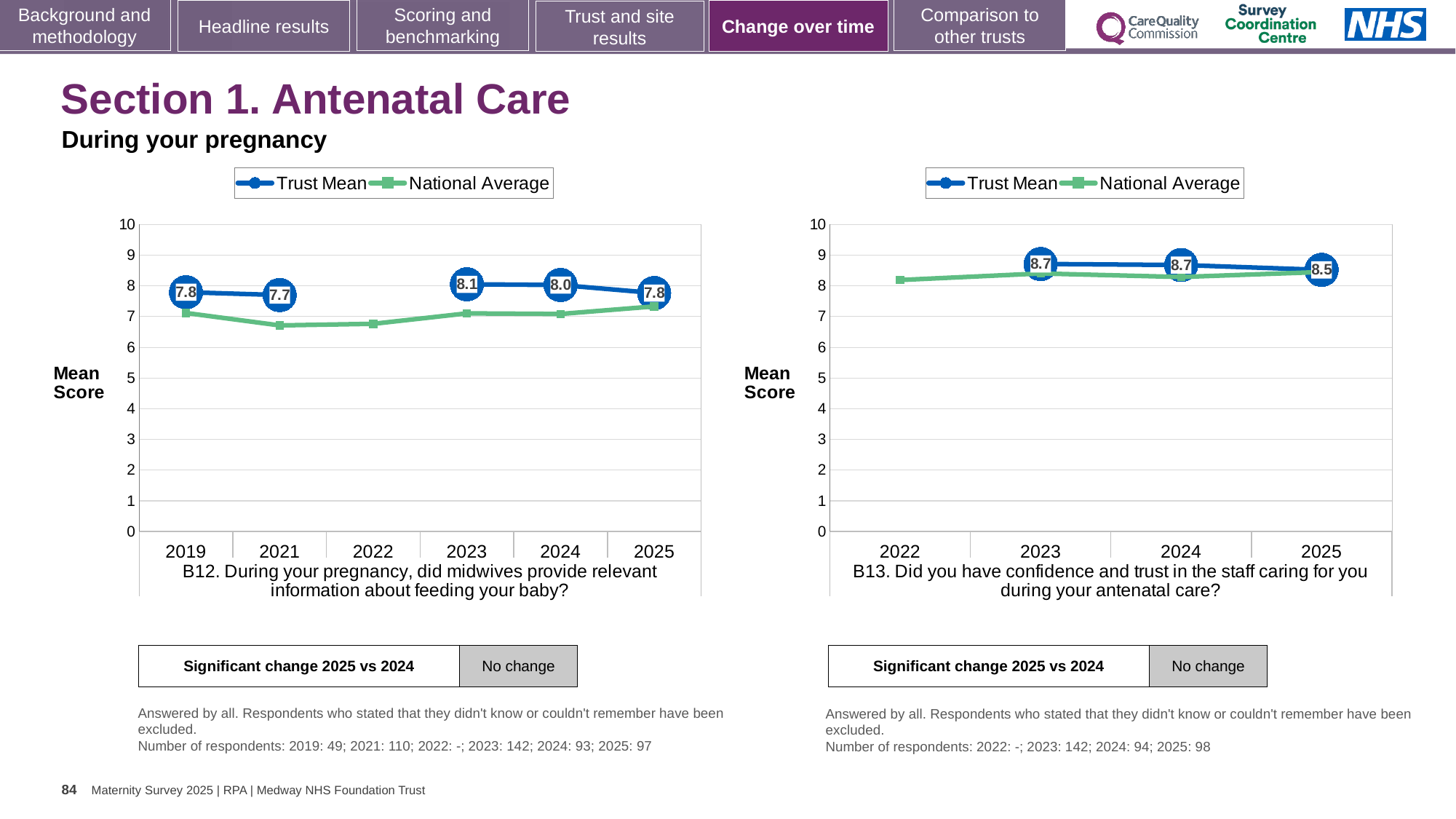
What kind of chart is the left chart (B12)? line chart In the right chart (B13), is the Trust Mean score for 2024 larger or smaller than the Trust Mean score for 2025? larger In the left chart (B12), which year has the lowest Trust Mean score? 2021 In the left chart (B12), which year has the highest Trust Mean score? 2023 In the left chart (B12), is the National Average value for 2021 greater or less than 7? less How many series does the legend of the right chart (B13) list? 2 How many years are shown on the x axis of the left chart (B12)? 6 In the right chart (B13), what is the Trust Mean score for 2025? 8.5 In the left chart (B12), what is the difference between the Trust Mean scores for 2023 and 2021? 0.4 In the left chart (B12), what is the Trust Mean score for 2023? 8.1 In the right chart (B13), does the Trust Mean score rise or fall from 2024 to 2025? fall How many years are shown on the x axis of the right chart (B13)? 4